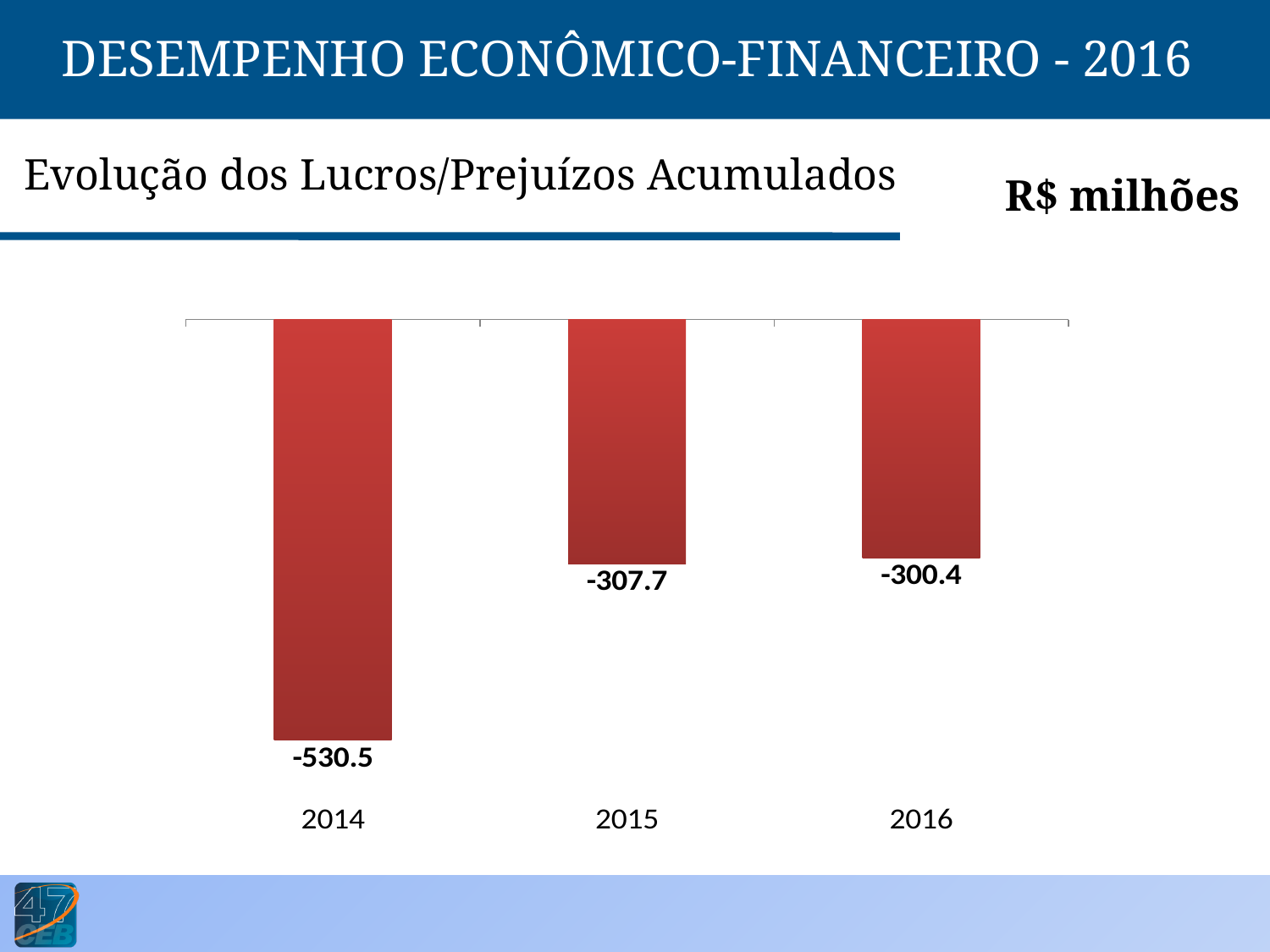
What is the value for 2015? -307.7 Which is larger, the value for 2015 or the value for 2014? 2015 Which year has the lowest (most negative) value? 2014 What is the value for 2014? -530.5 Do the values rise or fall from 2014 to 2016? rise What is the difference between the values for 2016 and 2015? 7.3 What is the value for 2016? -300.4 What is the difference between the values for 2015 and 2014? 222.8 Which year has the highest (least negative) value? 2016 What unit is stated for the chart values? R$ milhões How many years are shown on the chart? 3 What kind of chart is shown? bar chart